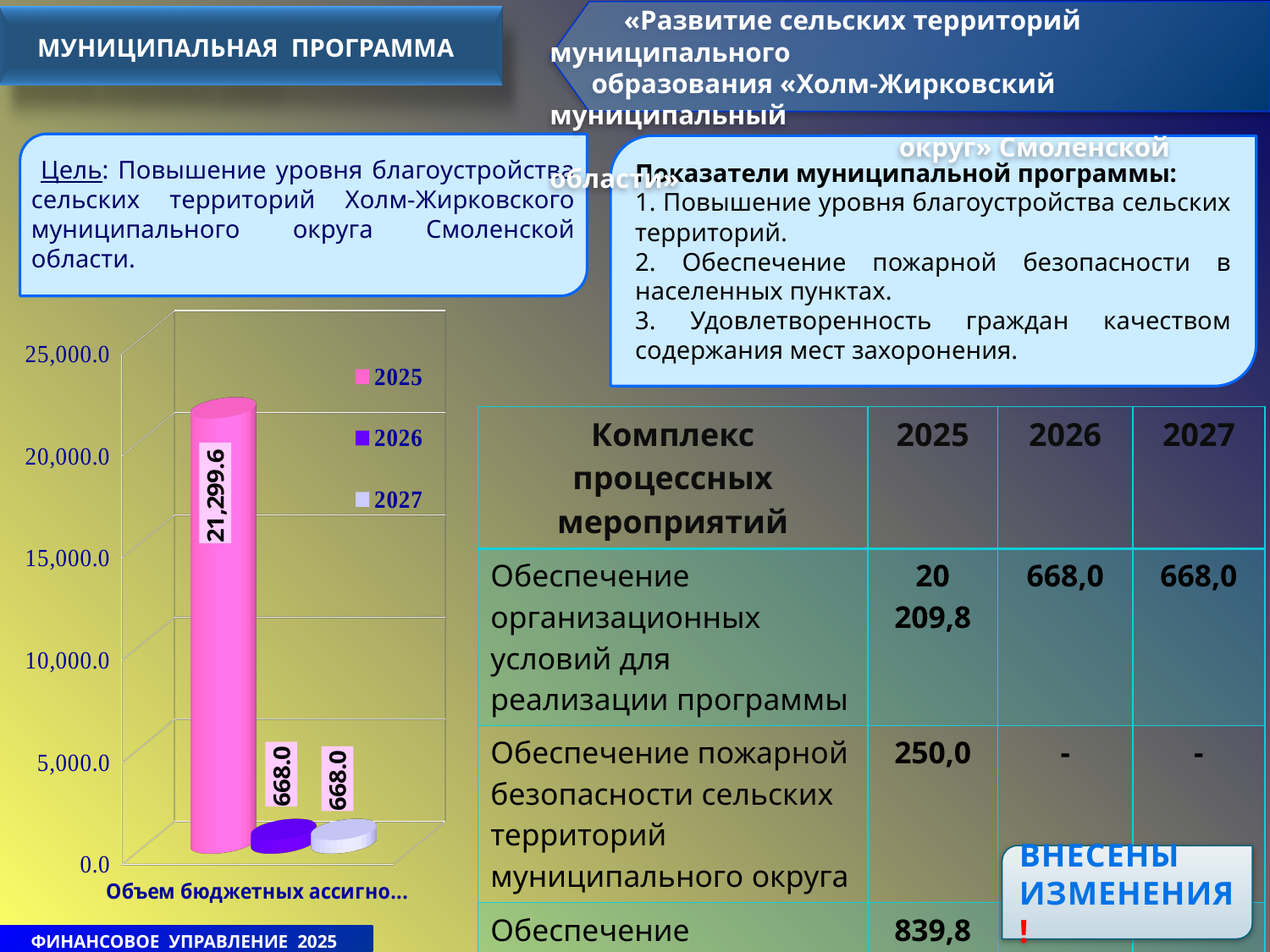
What is the value for 2026 in the chart? 668.0 Is the value for 2025 in the chart greater or less than 20,000.0? greater What is the value for 2025 in the chart? 21,299.6 Which is larger in the chart, the value for 2025 or the value for 2027? 2025 What is the value for 2027 in the chart? 668.0 Which colour represents the 2025 series in the chart legend? pink Is the value for 2026 in the chart greater or less than 5,000.0? less What is the highest value shown on the chart's vertical axis? 25,000.0 Which year has the highest value in the chart? 2025 What is the difference between the 2025 value and the 2026 value in the chart? 20,631.6 How many series does the chart legend list? 3 What kind of chart is shown on the slide? bar chart